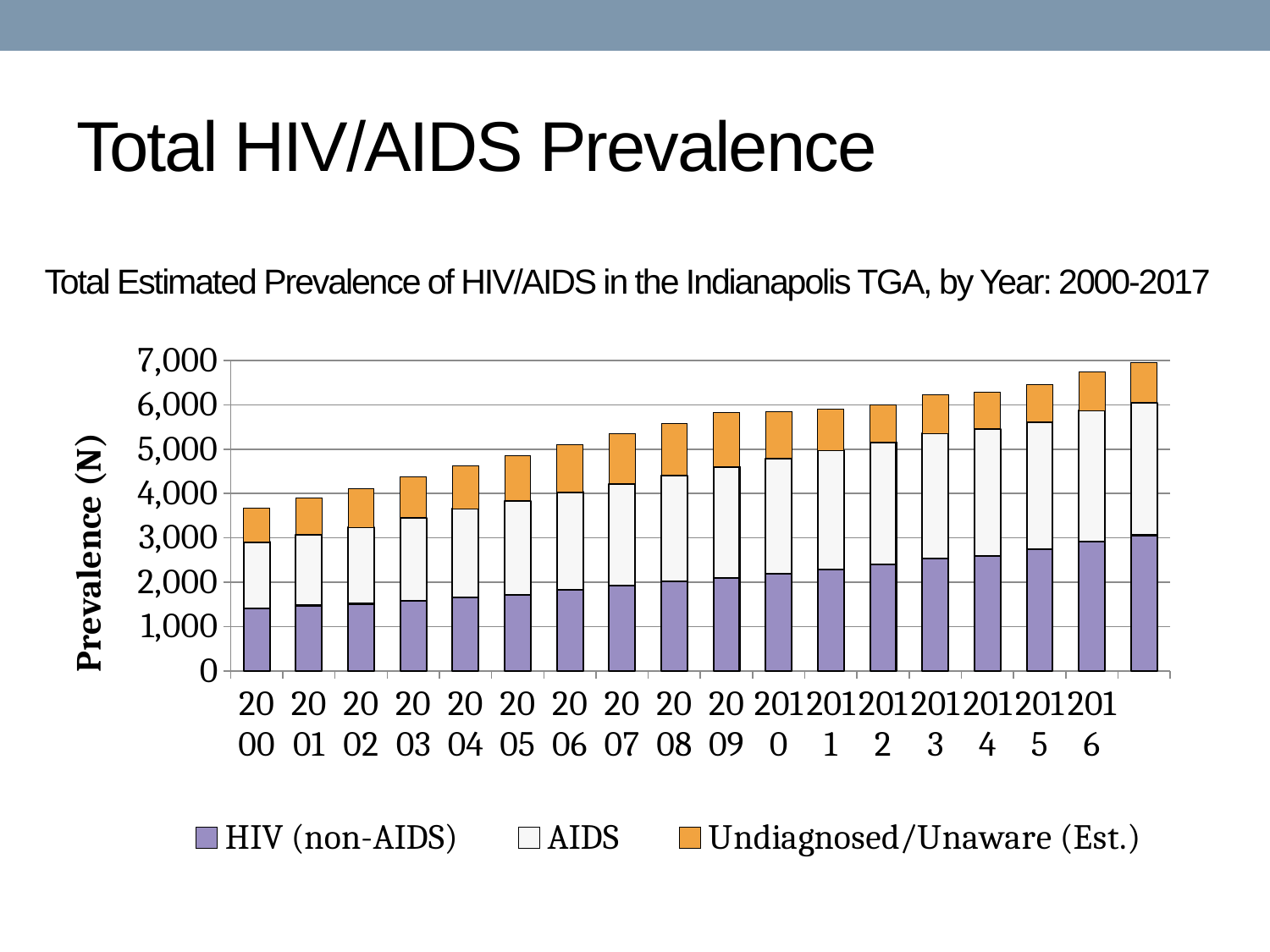
Is the HIV (non-AIDS) value for 2000 greater or less than 1,000? greater Is the total bar for 2008 greater or less than 5,000? greater How many series does the legend list? 3 What kind of chart is shown on the slide? Stacked bar chart How many bars are plotted in the chart? 18 Which labeled year has the lowest total prevalence? 2000 What is the title of the vertical axis? Prevalence (N) Is the total bar for 2016 greater or less than 6,000? greater Which series is shown in orange in the legend? Undiagnosed/Unaware (Est.) Which is larger, the total bar for 2016 or the total bar for 2000? 2016 Do the total bar heights rise or fall from 2000 to the right end of the x axis? Rise